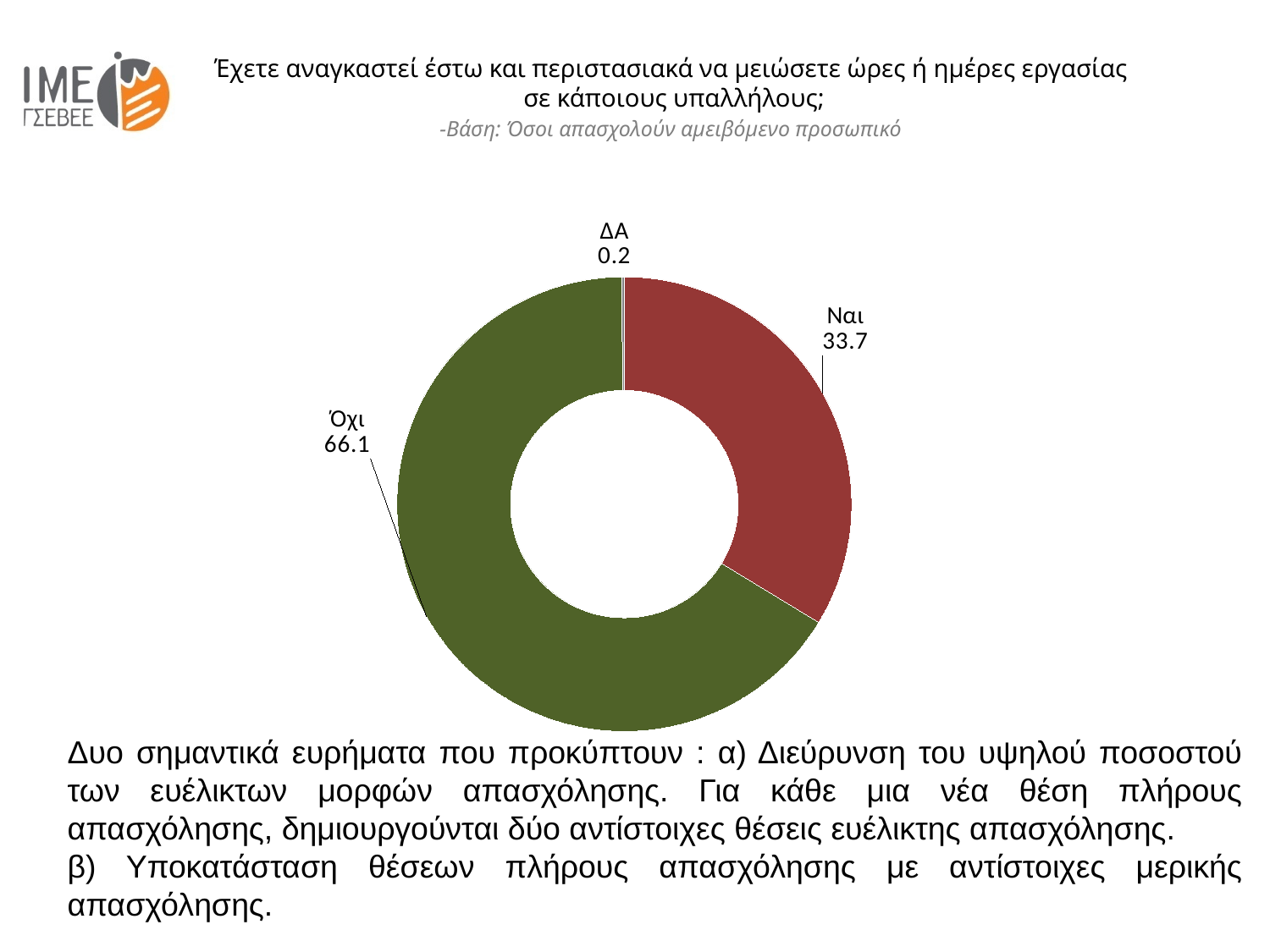
What colour is the Ναι slice? Red What value is shown for Ναι? 33.7 Which is larger, the value for Ναι or the value for Όχι? Όχι What is the difference between the values for Όχι and Ναι? 32.4 What value is shown for ΔΑ? 0.2 Which category has the smallest share of the chart? ΔΑ What colour is the Όχι slice? Green What value is shown for Όχι? 66.1 Which category has the largest share of the chart? Όχι What kind of chart is shown on the slide? Doughnut chart What is the difference between the values for Ναι and ΔΑ? 33.5 How many categories are shown in the chart? 3